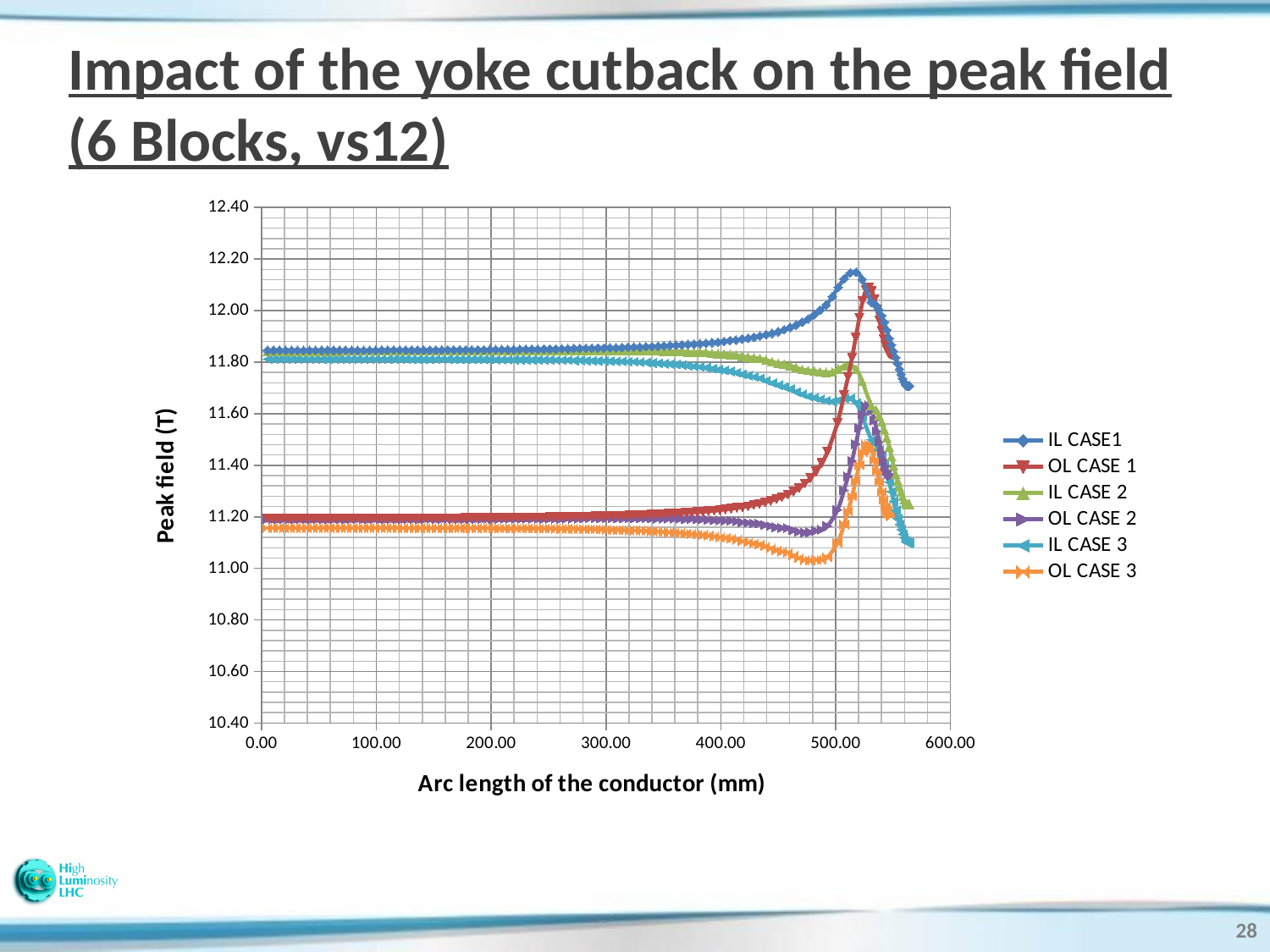
Does the IL CASE1 series rise or fall between arc lengths of 400.00 mm and 500.00 mm? rise Is the value of OL CASE 2 at an arc length of 300.00 mm greater or less than 11.40? less At an arc length of 0.00 mm, which series has the higher peak field: IL CASE1 or OL CASE 1? IL CASE1 What is the title of the horizontal axis? Arc length of the conductor (mm) What kind of chart is shown on the slide? Line chart Which series reaches the lowest peak field value anywhere on the chart? OL CASE 3 Is the peak value of the IL CASE1 series greater or less than 12.00? greater Is the lowest value of the OL CASE 3 series greater or less than 11.20? less How many series does the legend list? 6 What is the title of the vertical axis? Peak field (T)